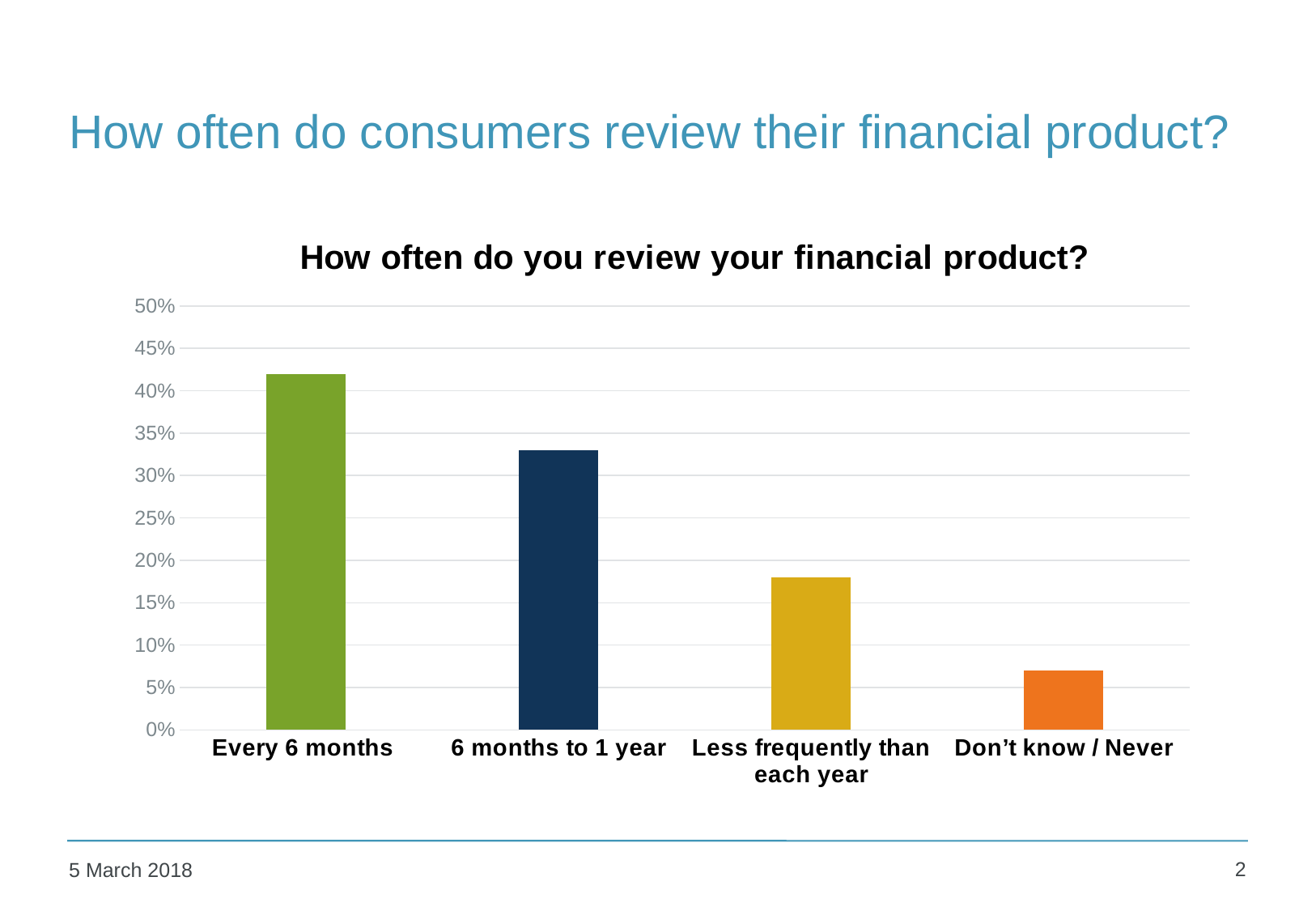
How many categories are shown on the x axis? 4 Which category has the lowest value? Don't know / Never What kind of chart is shown on the slide? bar chart Is the value for Less frequently than each year greater or less than 15%? greater Which category has the highest value? Every 6 months Is the value for 6 months to 1 year greater or less than 35%? less Is the value for Don't know / Never greater or less than 10%? less What is the title of the chart? How often do you review your financial product? Do the values rise or fall moving from left to right along the x axis? fall What colour is the bar for Every 6 months? green Which is larger, the value for 6 months to 1 year or the value for Less frequently than each year? 6 months to 1 year